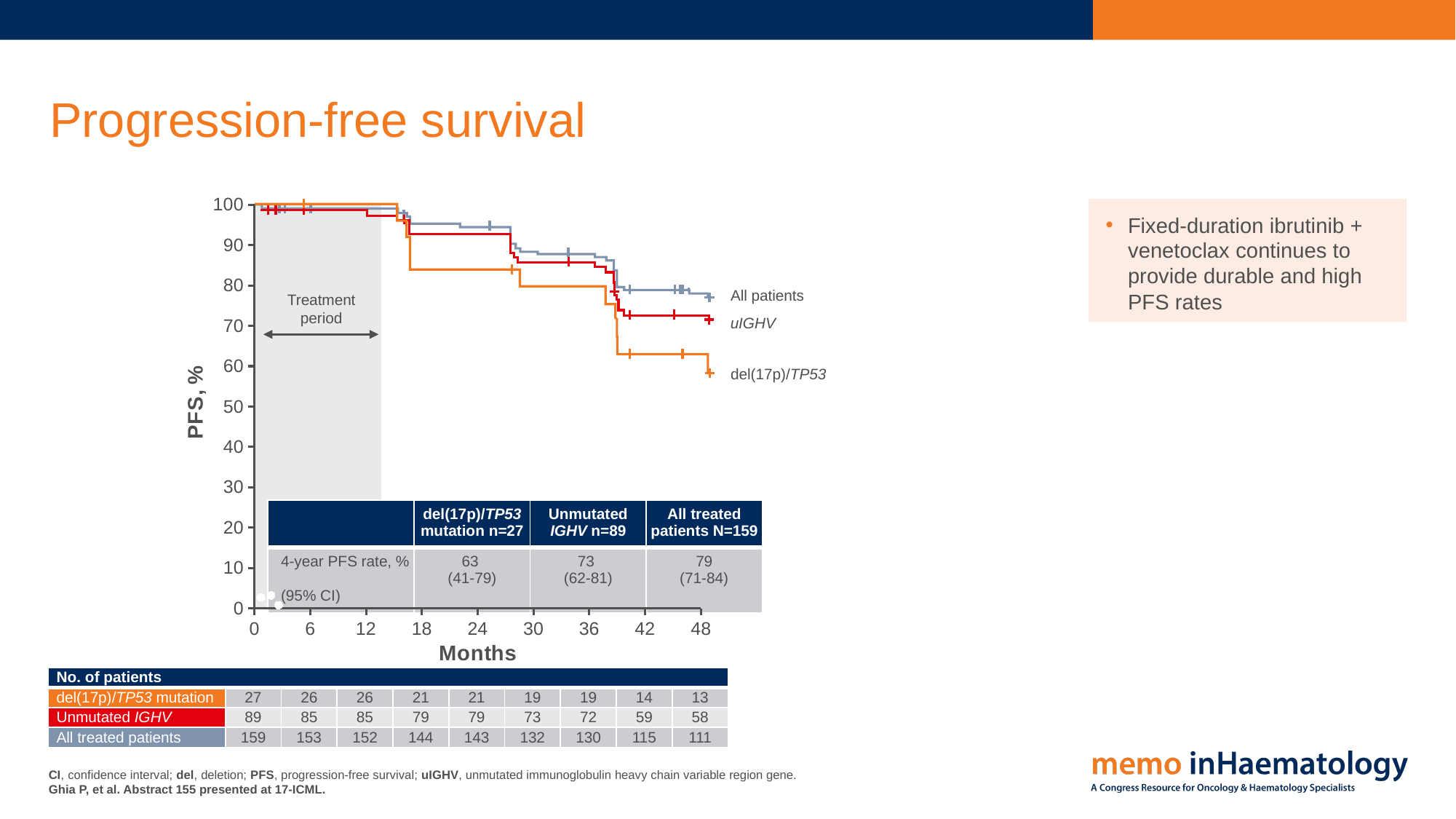
Which group has the lowest 4-year PFS rate? del(17p)/TP53 mutation What is the 4-year PFS rate for the Unmutated IGHV group? 73 What is the 4-year PFS rate for all treated patients? 79 What is the label of the y-axis on the chart? PFS, % What is the 4-year PFS rate for the del(17p)/TP53 mutation group? 63 Do the PFS curves rise or fall as months increase? Fall Is the PFS value for the All patients curve at 48 months greater or less than 70%? greater Which group has the highest 4-year PFS rate? All treated patients How many patient groups (series) are plotted on the PFS chart? 3 What kind of chart is shown on the slide? Line chart What is the difference in 4-year PFS rate between all treated patients and the del(17p)/TP53 mutation group? 16